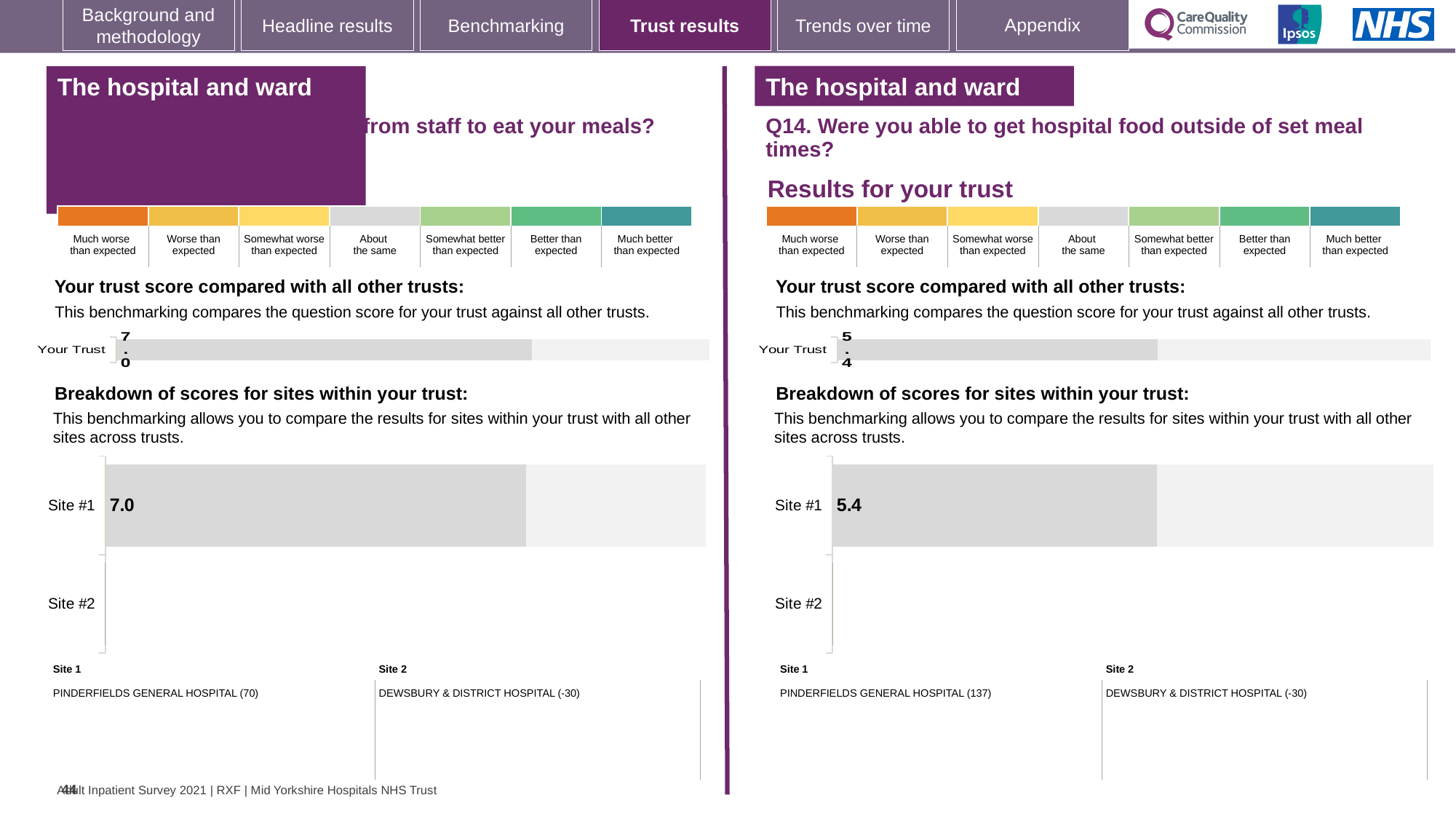
What is the difference between the Site #1 value in the left breakdown chart and the Site #1 value in the right breakdown chart? 1.6 On the left half of the slide, what is the value shown for Your Trust in the 'Your trust score compared with all other trusts' chart? 7.0 Which is larger: the Site #1 value in the left breakdown chart or the Site #1 value in the right breakdown chart? Left (7.0) On the right half of the slide (Q14), what is the value shown for Your Trust in the 'Your trust score compared with all other trusts' chart? 5.4 Is the Your Trust value on the right half of the slide (Q14) greater or less than the Your Trust value on the left half? less How many site categories are listed on the axis of the right 'Breakdown of scores for sites within your trust' chart? 2 How many site categories are listed on the axis of the left 'Breakdown of scores for sites within your trust' chart? 2 What type of chart is used to show the Your Trust score on the right half of the slide? Bar chart In the left 'Breakdown of scores for sites within your trust' chart, what is the value for Site #1? 7.0 In the right breakdown chart (Q14), which site has a bar plotted? Site #1 In the right 'Breakdown of scores for sites within your trust' chart (Q14), what is the value for Site #1? 5.4 Which hospital is listed as Site 1 in the table below the right breakdown chart? PINDERFIELDS GENERAL HOSPITAL (137)